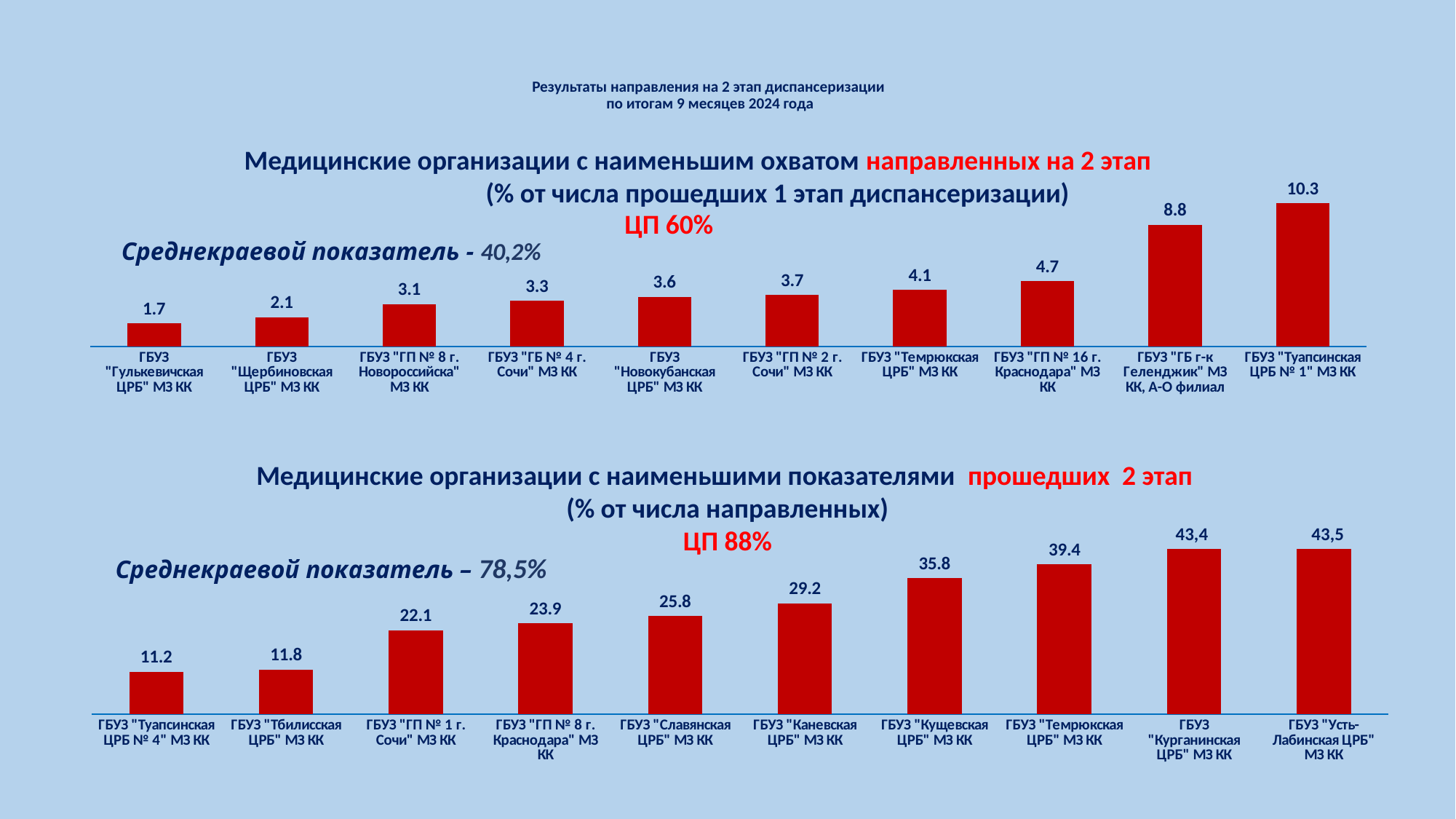
In the bottom chart, what is the difference between the values for ГБУЗ "Темрюкская ЦРБ" МЗ КК and ГБУЗ "Тбилисская ЦРБ" МЗ КК? 27.6 In the top chart (Медицинские организации с наименьшим охватом направленных на 2 этап), what is the value for ГБУЗ "Гулькевичская ЦРБ" МЗ КК? 1.7 In the top chart, how many organisations are shown? 10 In the bottom chart (Медицинские организации с наименьшими показателями прошедших 2 этап), what is the value for ГБУЗ "Славянская ЦРБ" МЗ КК? 25.8 In the top chart, what is the difference between the values for ГБУЗ "Туапсинская ЦРБ № 1" МЗ КК and ГБУЗ "Гулькевичская ЦРБ" МЗ КК? 8.6 In the bottom chart, what is the value for ГБУЗ "Усть-Лабинская ЦРБ" МЗ КК? 43,5 In the bottom chart, which organisation has the lowest value? ГБУЗ "Туапсинская ЦРБ № 4" МЗ КК In the top chart, do the values rise or fall from left to right? rise In the top chart, which organisation has the highest value? ГБУЗ "Туапсинская ЦРБ № 1" МЗ КК What type of chart is used in the bottom chart? bar chart In the top chart, what is the value for ГБУЗ "ГБ г-к Геленджик" МЗ КК, А-О филиал? 8.8 In the bottom chart, which is larger: the value for ГБУЗ "Кущевская ЦРБ" МЗ КК or ГБУЗ "Каневская ЦРБ" МЗ КК? ГБУЗ "Кущевская ЦРБ" МЗ КК